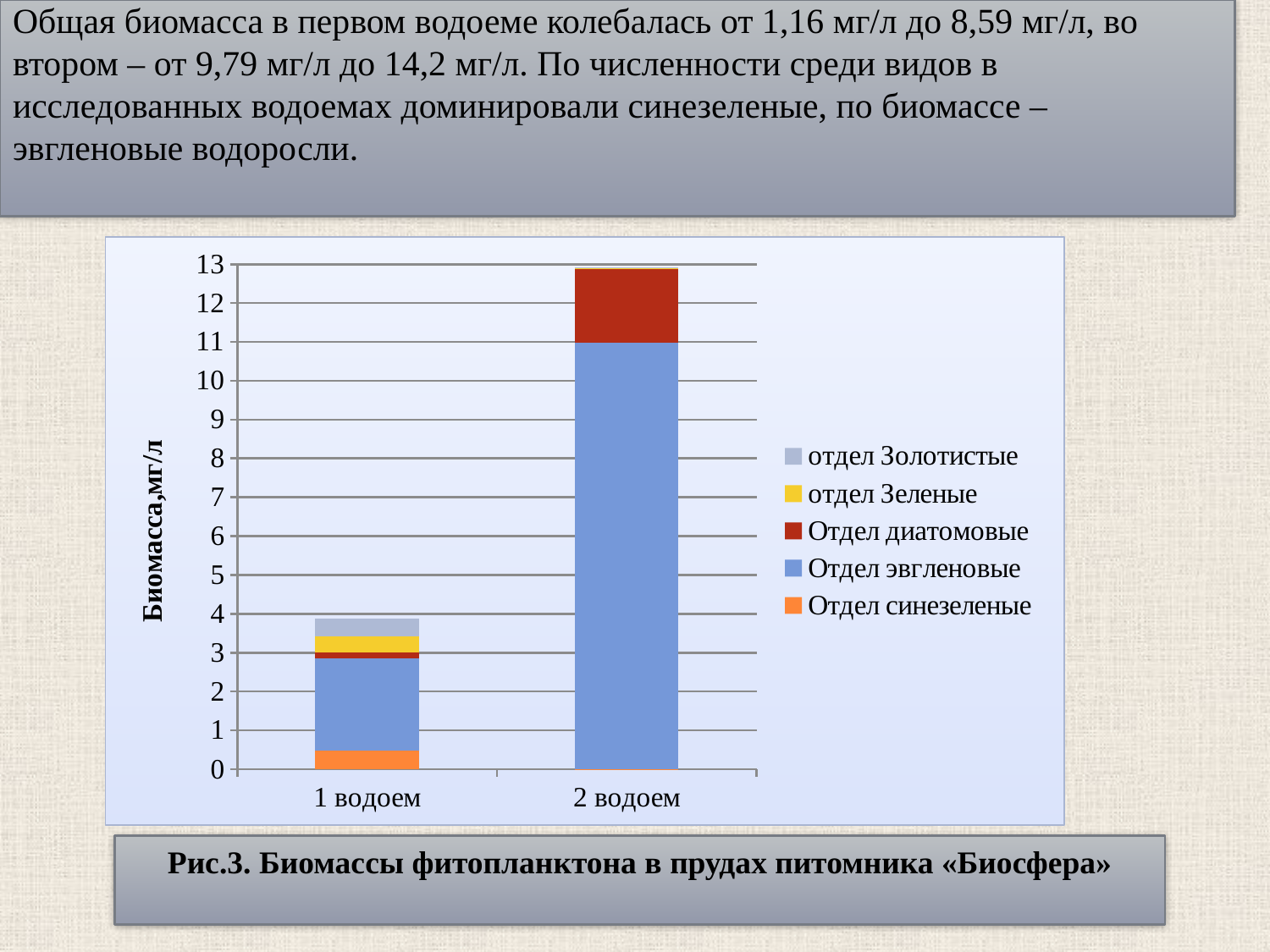
Which series is shown in orange in the legend? Отдел синезеленые Which category has the shorter stacked bar? 1 водоем What is the label of the vertical axis of the chart? Биомасса,мг/л Is the Отдел эвгленовые segment for 2 водоем greater or less than 10? greater How many series does the chart's legend list? 5 Is the Отдел синезеленые segment for 1 водоем greater or less than 1? less Which category has the taller stacked bar, 1 водоем or 2 водоем? 2 водоем What kind of chart is shown on the slide? stacked bar chart Is the total height of the bar for 2 водоем greater or less than 12? greater Do the bar totals rise or fall from 1 водоем to 2 водоем? rise How many categories are shown on the x axis of the chart? 2